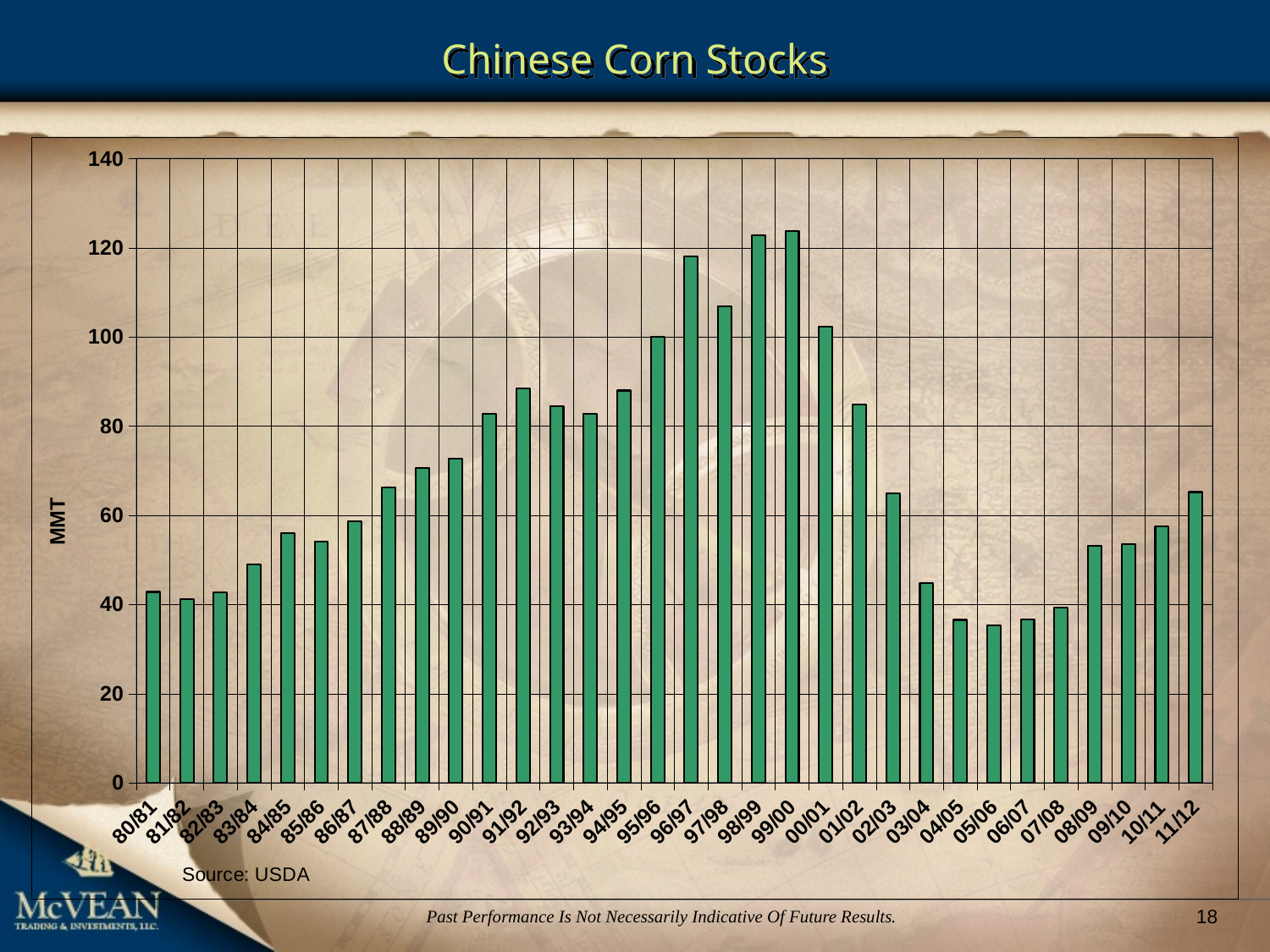
Is the value for 98/99 greater or less than 120? greater Which is larger, the value for 11/12 or the value for 07/08? 11/12 How many marketing years (bars) are plotted on the chart? 32 What unit is shown on the y-axis label? MMT Is the value for 96/97 greater or less than 100? greater Is the value for 05/06 greater or less than 40? less Which is larger, the value for 99/00 or the value for 00/01? 99/00 What is the title of the chart? Chinese Corn Stocks Do the values generally rise or fall from 99/00 to 05/06? fall What type of chart is shown on the slide? bar chart